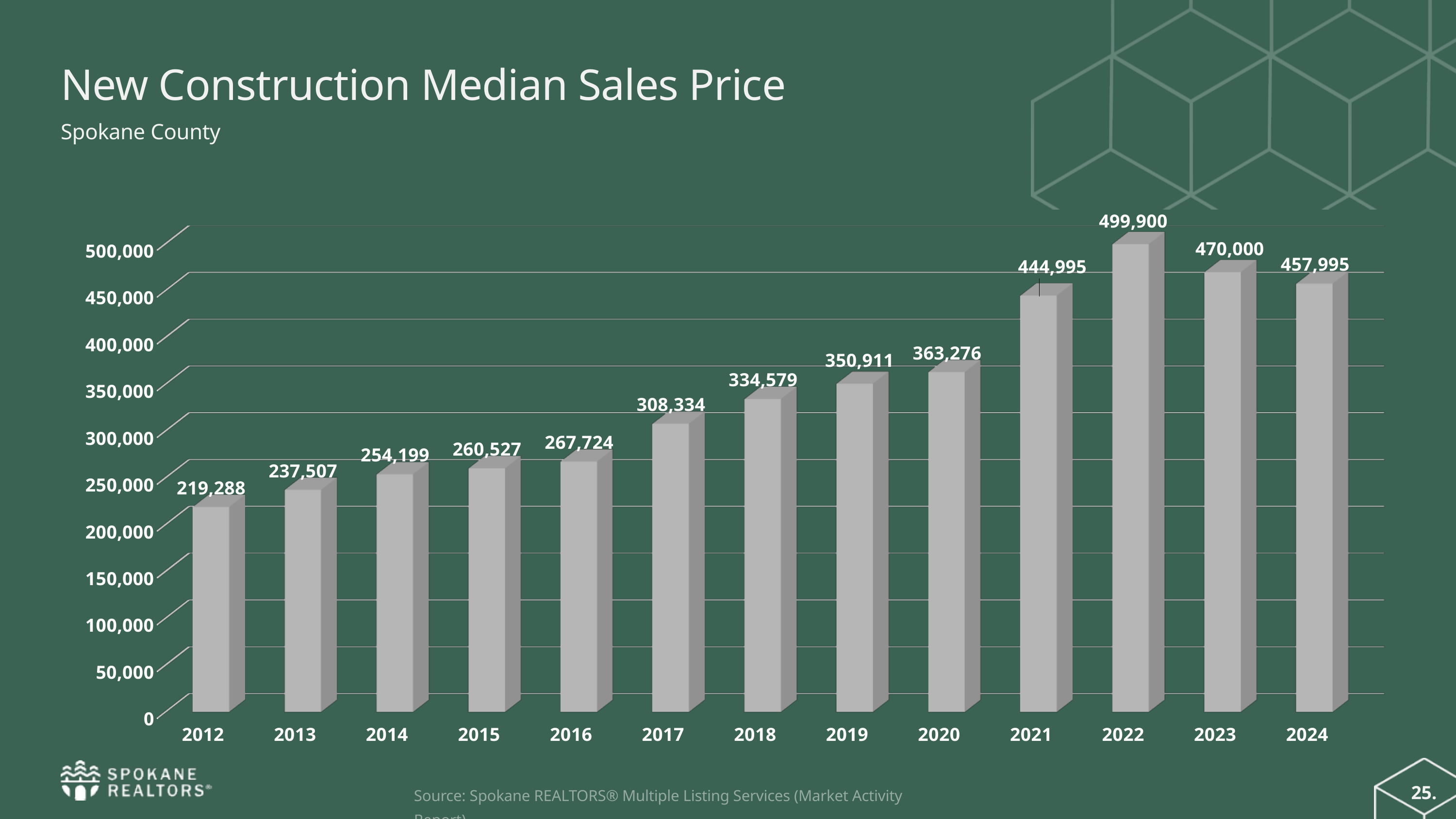
How many years are shown on the x axis? 13 What is the new construction median sales price for 2020? 363,276 What is the new construction median sales price for 2024? 457,995 Is the value for 2019 greater or less than 400,000? less What is the new construction median sales price for 2012? 219,288 What is the difference between the median sales price in 2021 and in 2020? 81,719 What is the subtitle shown under the chart title? Spokane County What kind of chart is shown on the slide? Bar chart Which year has the lowest new construction median sales price? 2012 Which year has a higher median sales price, 2023 or 2024? 2023 What is the difference between the median sales price in 2022 and in 2023? 29,900 Which year has the highest new construction median sales price? 2022